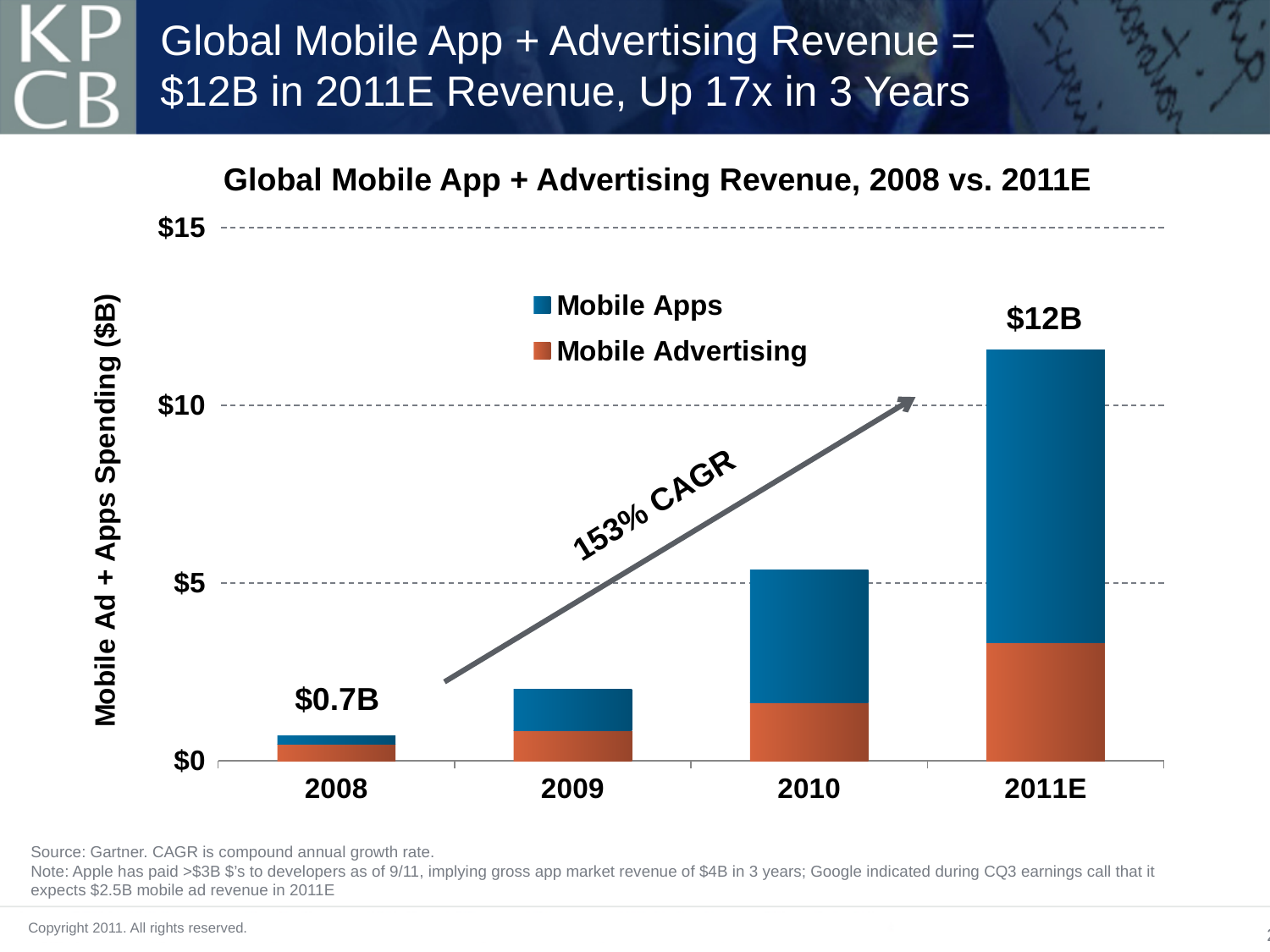
Which is larger, the total revenue for 2010 or for 2009? 2010 Is the total value for 2010 greater or less than $5? greater Which year has the lowest total revenue in the chart? 2008 What kind of chart is shown on the slide? Stacked bar chart Which year has the highest total revenue in the chart? 2011E Is the total value for 2009 greater or less than $5? less What is the total Global Mobile App + Advertising Revenue shown for 2011E? $12B What is the total Global Mobile App + Advertising Revenue shown for 2008? $0.7B What is the difference between the total revenue labels for 2011E and 2008? $11.3B How many years are shown on the x axis of the chart? 4 How many series does the legend list? 2 What CAGR is annotated on the chart? 153% CAGR